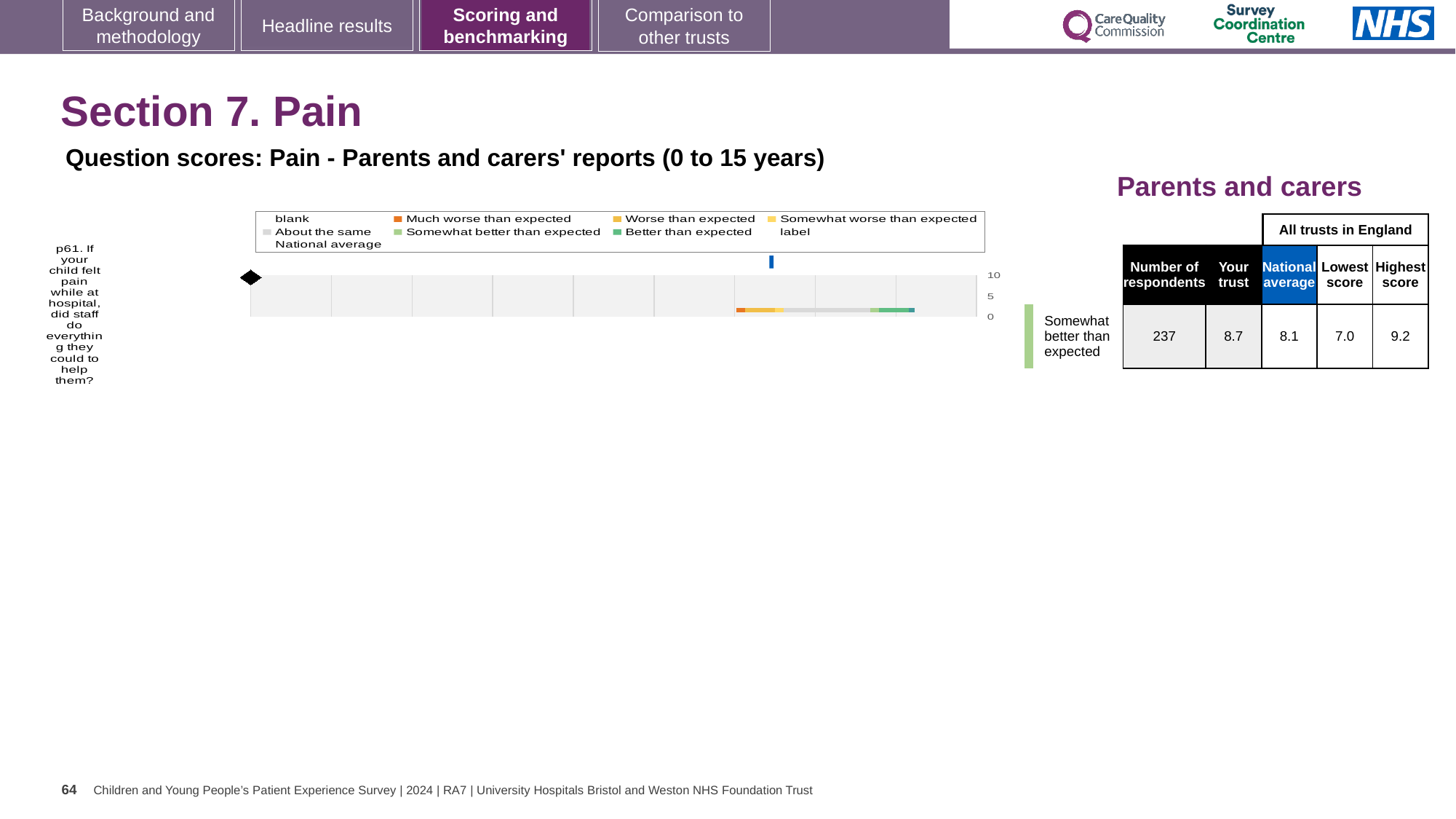
What is the highest value shown on the chart's axis? 10 Which benchmark category is the trust's result for question p61 placed in? Somewhat better than expected What is the difference between the Your trust score and the National average for question p61? 0.6 What is the difference between the Highest score and the Lowest score for question p61? 2.2 What kind of chart is shown on the slide for question p61? bar chart According to the table beside the chart, what is the score for Your trust on question p61? 8.7 According to the table beside the chart, what is the National average score for question p61? 8.1 Which is higher for question p61: the Your trust score or the National average? Your trust What is the Lowest score among all trusts in England for question p61? 7.0 What is the Highest score among all trusts in England for question p61? 9.2 How many respondents answered question p61 according to the table? 237 What colour does the chart legend use for 'Much worse than expected'? orange